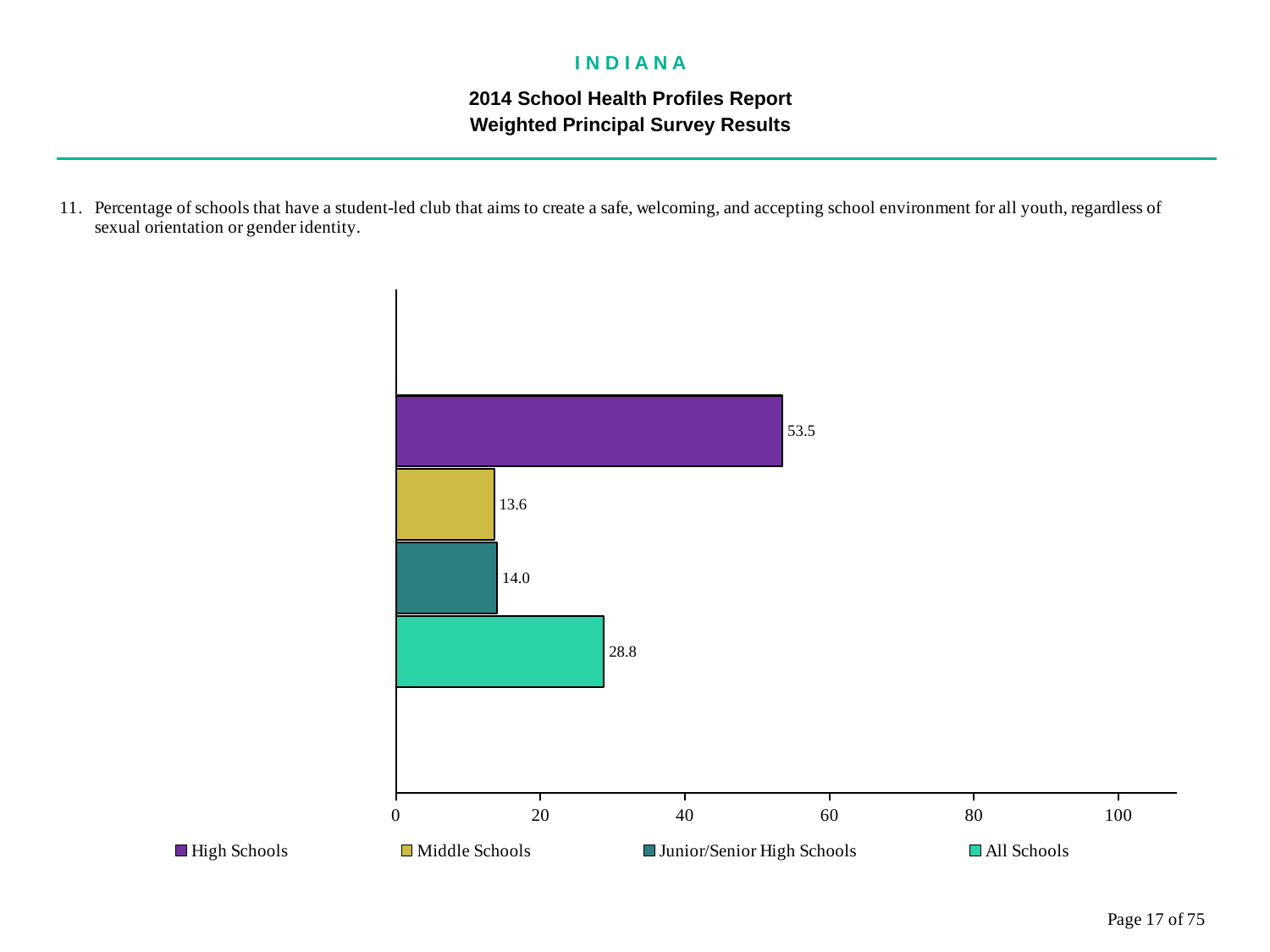
How many series does the legend list? 4 Is the value for All Schools greater or less than 40? less Which school type has the lowest value? Middle Schools What is the value for All Schools? 28.8 What is the difference between the Junior/Senior High Schools value and the Middle Schools value? 0.4 Which school type has the highest value? High Schools What is the value for Junior/Senior High Schools? 14.0 Which is larger, the value for High Schools or the value for All Schools? High Schools What is the difference between the High Schools value and the All Schools value? 24.7 What is the value for Middle Schools? 13.6 What is the value for High Schools? 53.5 What kind of chart is shown on the slide? bar chart